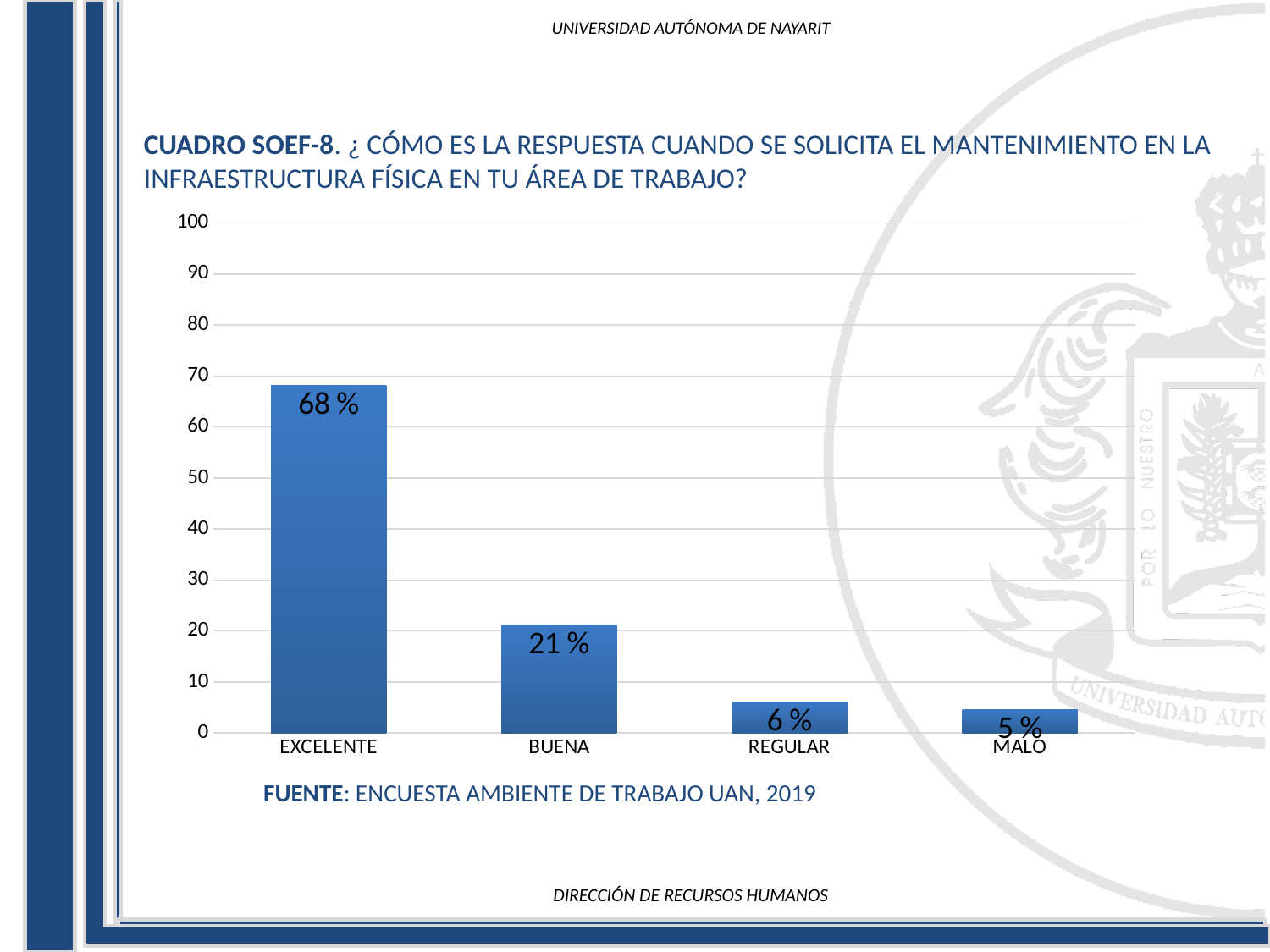
What is the value for BUENA? 21 % What is the value for MALO? 5 % What is the difference between the values for BUENA and REGULAR? 15 % What is the difference between the values for EXCELENTE and BUENA? 47 % Which category has the highest value? EXCELENTE What kind of chart is shown on the slide? bar chart Which is larger, the value for BUENA or the value for REGULAR? BUENA What is the value for EXCELENTE? 68 % What is the value for REGULAR? 6 % How many categories are shown on the x axis? 4 Is the value for EXCELENTE greater or less than 60? greater Do the values rise or fall from left to right along the x axis? fall